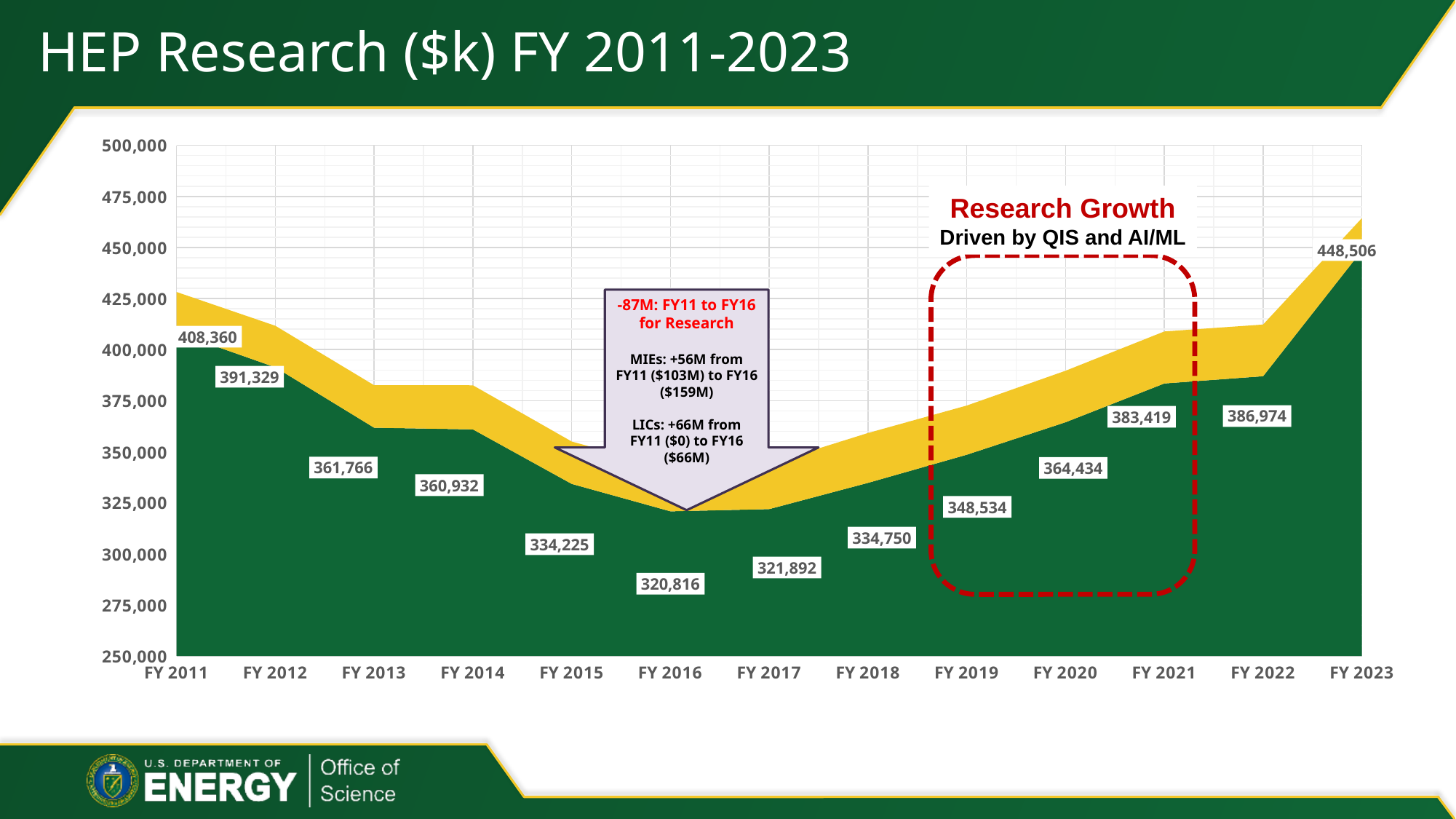
What is the labeled value for FY 2016? 320,816 What is the labeled value for FY 2023? 448,506 Which is larger, the labeled value for FY 2019 or for FY 2021? FY 2021 What is the difference between the labeled values for FY 2023 and FY 2022? 61,532 Do the labeled values rise or fall from FY 2016 to FY 2023? Rise What kind of chart is shown on the slide? Area chart What is the difference between the labeled values for FY 2011 and FY 2016? 87,544 Which fiscal year has the highest labeled value? FY 2023 What is the labeled value for FY 2020? 364,434 Which fiscal year has the lowest labeled value? FY 2016 How many fiscal years are shown on the x axis? 13 What is the labeled value for FY 2011? 408,360